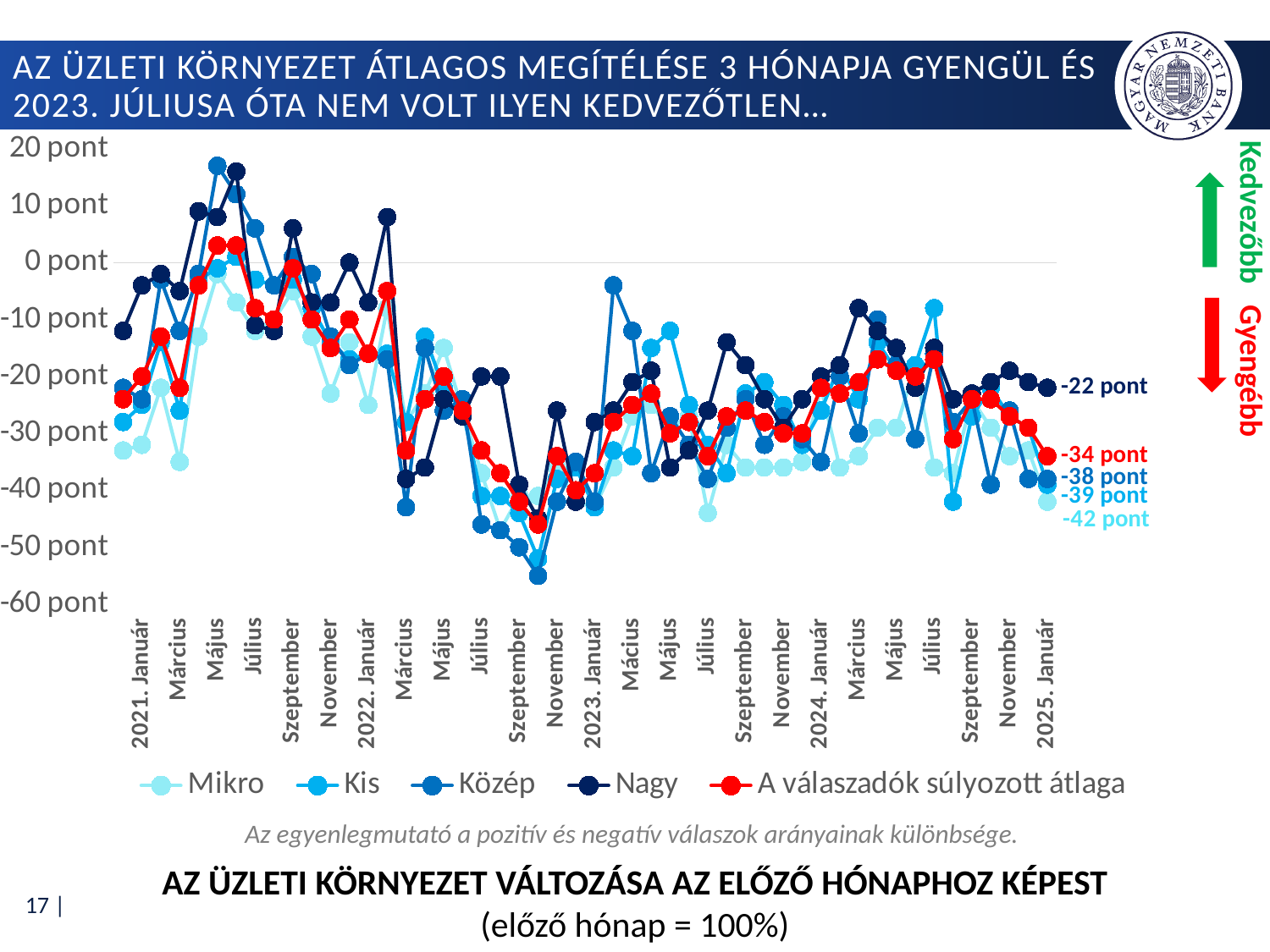
Which series has the lowest value at 2025. Január? Mikro What is the value of the Kis series at 2025. Január? -39 pont How many series does the legend list? 5 Which series has the highest value at 2025. Január? Nagy What is the value of the Mikro series at 2025. Január? -42 pont Which series is drawn in red? A válaszadók súlyozott átlaga What is the difference between the Nagy value and the Mikro value at 2025. Január? 20 pont What type of chart is shown on the slide? line chart What is the value of the Közép series at 2025. Január? -38 pont What is the value of 'A válaszadók súlyozott átlaga' at 2025. Január? -34 pont What is the value of the Nagy series at 2025. Január? -22 pont